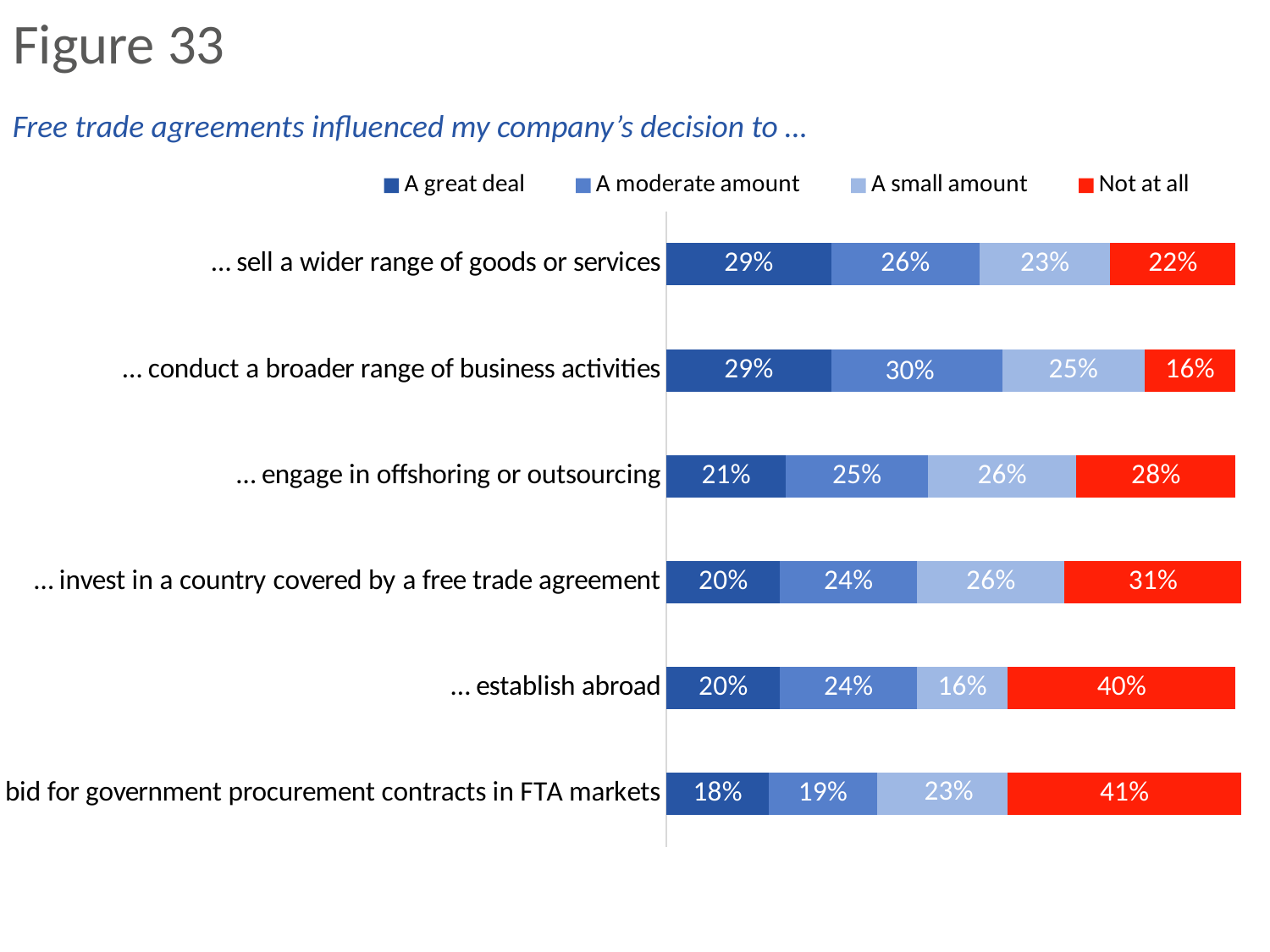
How many categories (decisions) are shown in the chart? 6 How many series does the legend list? 4 What is the difference between the "Not at all" values for "... establish abroad" and "... sell a wider range of goods or services"? 18% What is the "A small amount" value for "... engage in offshoring or outsourcing"? 26% Which is larger: the "A moderate amount" value for "... conduct a broader range of business activities" or for "... invest in a country covered by a free trade agreement"? ... conduct a broader range of business activities What is the total of the stacked bar for "... sell a wider range of goods or services"? 100% Which category has the highest "Not at all" value? ... bid for government procurement contracts in FTA markets What percentage of respondents said free trade agreements influenced their company's decision to establish abroad "Not at all"? 40% What kind of chart is shown on the slide? Stacked bar chart Which category has the lowest "A great deal" value? ... bid for government procurement contracts in FTA markets What is the "A moderate amount" value for "... bid for government procurement contracts in FTA markets"? 19% What is the "A great deal" value for "... conduct a broader range of business activities"? 29%